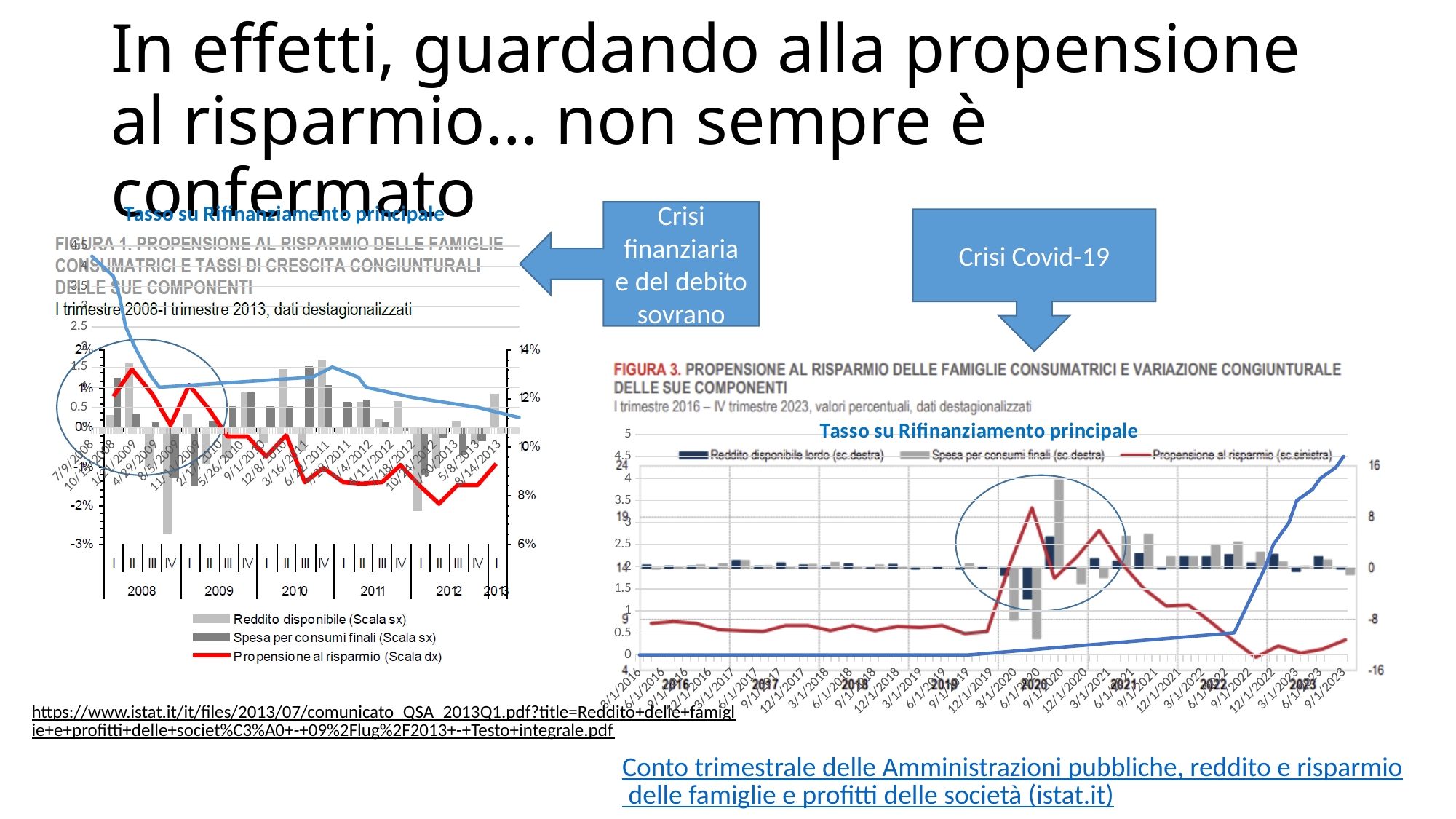
How many series does the legend of the right chart (Figura 3) list? 3 What is the highest tick shown on the right-hand axis of the left chart (Figura 1)? 14% How many years are labelled along the x axis of the left chart (Figura 1)? 6 In the left chart (Figura 1), is the Propensione al risparmio value in the first quarter of 2008 greater or less than 10%? greater In the right chart (Figura 3), which series is plotted on the left scale (sc.sinistra)? Propensione al risparmio In the right chart (Figura 3), is the Propensione al risparmio value in 2017 greater or less than 14 on the left axis? less In the left chart (Figura 1), what colour is the Propensione al risparmio line? Red What kind of chart is the left chart (Figura 1)? Combined bar and line chart In the left chart (Figura 1), does the Propensione al risparmio line overall rise or fall from 2008 to 2012? Fall In the right chart (Figura 3), in which year does the Propensione al risparmio line reach its highest peak? 2020 In the right chart (Figura 3), in which year is the tallest Spesa per consumi finali bar? 2020 How many series does the legend of the left chart (Figura 1) list? 3